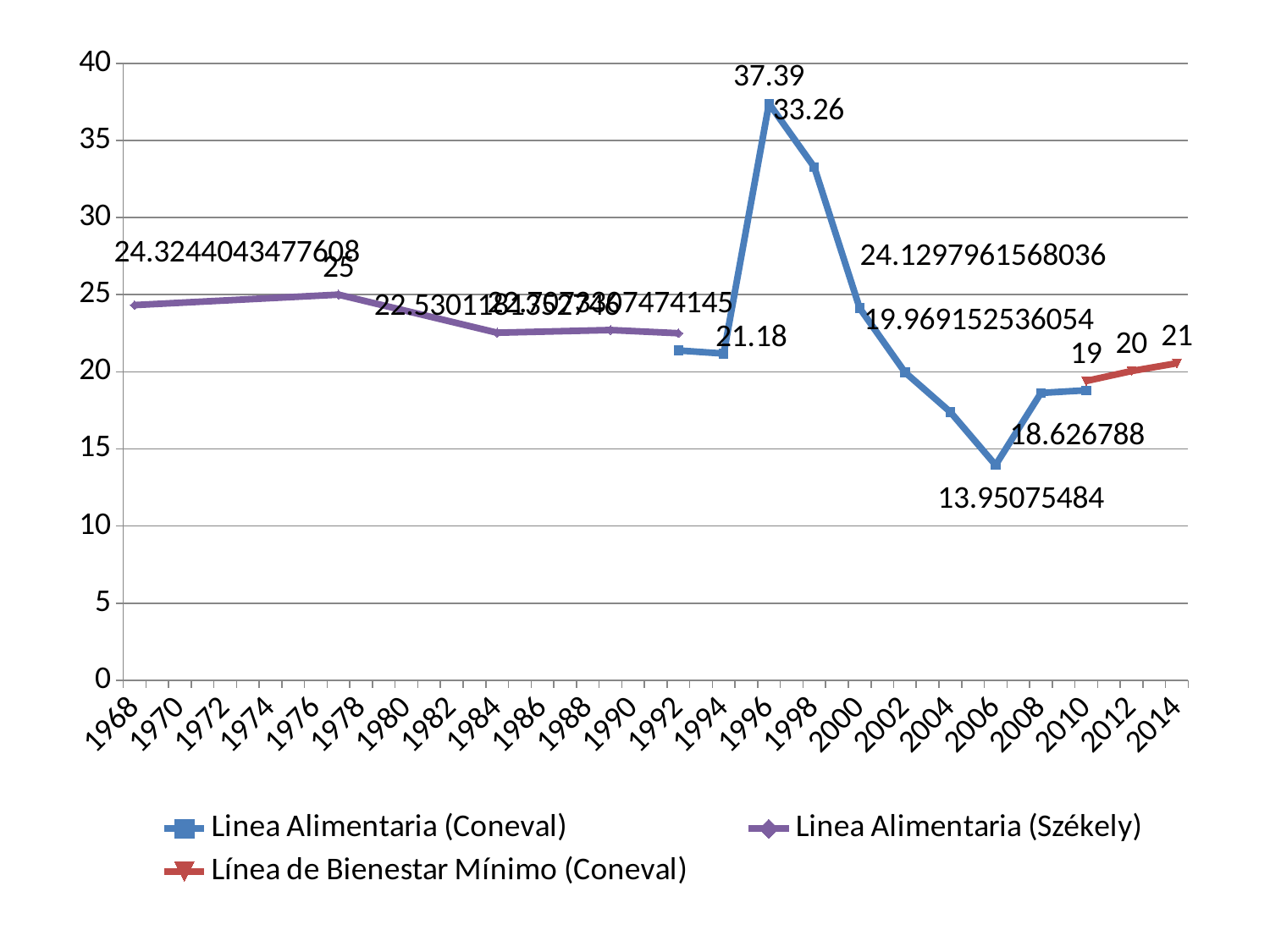
Is the value of Linea Alimentaria (Coneval) in 2004 greater or less than 20? less In which year does the Linea Alimentaria (Coneval) series reach its highest value? 1996 What kind of chart is shown on the slide? line chart What is the lowest value of the Linea Alimentaria (Coneval) series? 13.95075484 How many series does the legend list? 3 What is the value of Linea Alimentaria (Székely) at its peak around 1977? 25 What is the highest value of the Linea Alimentaria (Coneval) series? 37.39 What is the value of Línea de Bienestar Mínimo (Coneval) in 2014? 21 Does the Línea de Bienestar Mínimo (Coneval) series rise or fall from 2010 to 2014? rise What is the difference between the Linea Alimentaria (Coneval) values in 1996 and 1998? 4.13 What is the value of Linea Alimentaria (Coneval) in 1998? 33.26 What is the value of Linea Alimentaria (Coneval) in 1994? 21.18